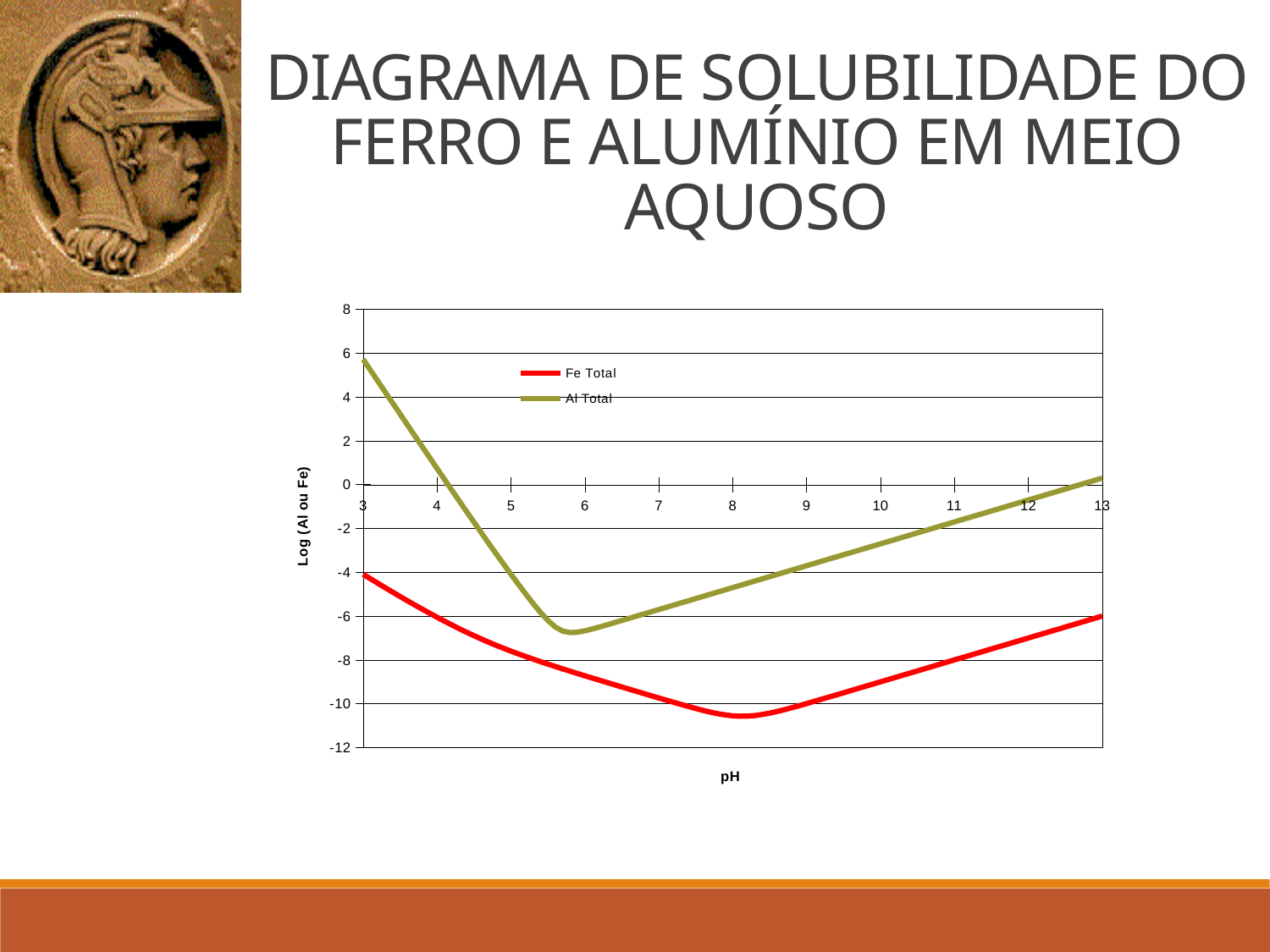
What is the label of the x axis of the chart? pH Does the Al Total line rise or fall as pH increases from 7 to 13? rise Is the value of Fe Total at pH 13 greater or less than -4? less At pH 8, which series has the larger value, Fe Total or Al Total? Al Total Does the Fe Total line rise or fall as pH increases from 3 to 8? fall Is the value of Fe Total at pH 8 greater or less than -8? less What are the two series named in the chart legend? Fe Total and Al Total Is the value of Al Total at pH 6 greater or less than -4? less What kind of chart is shown on the slide? line chart How many series does the chart legend list? 2